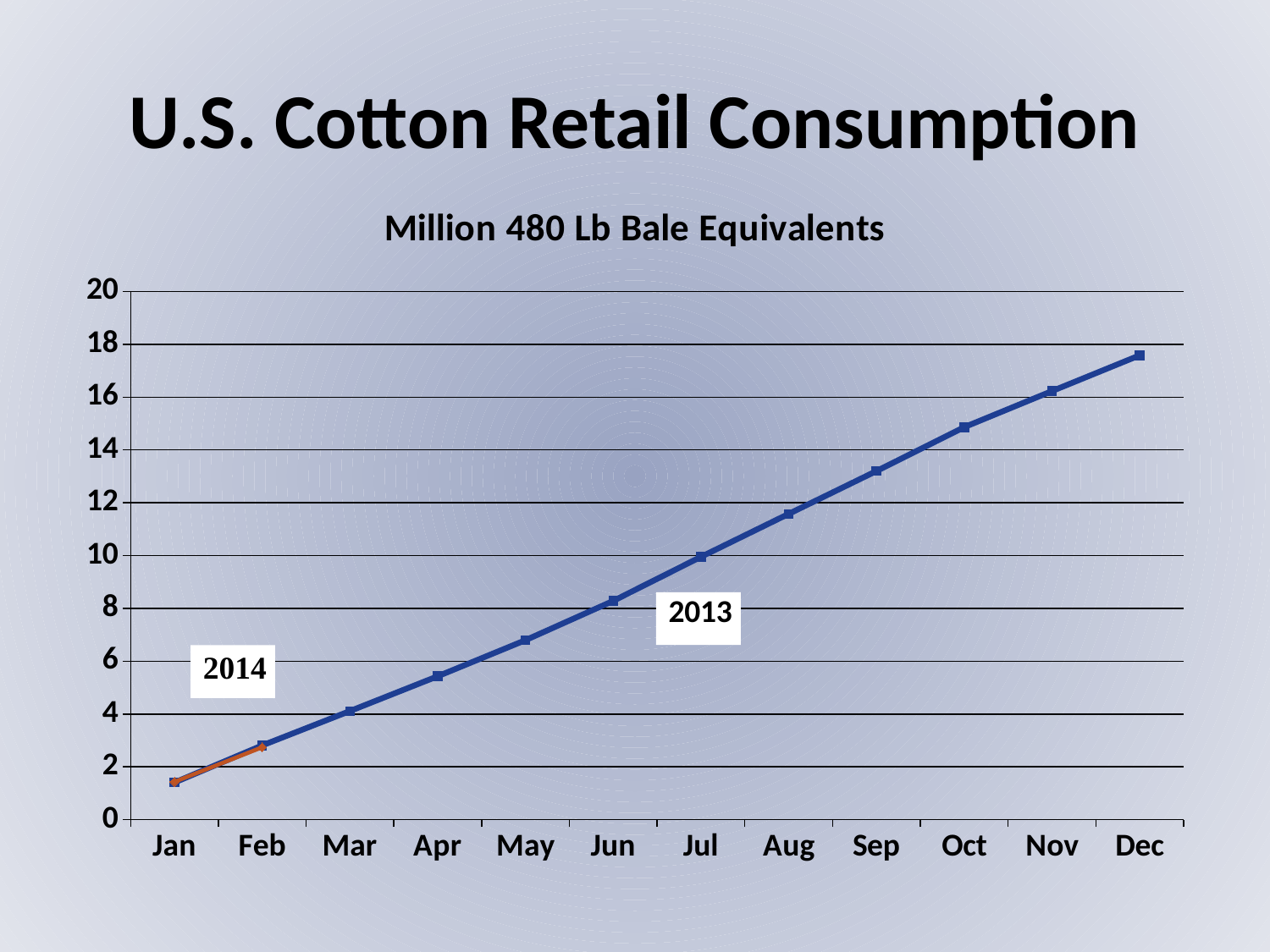
Is the 2013 value for Dec greater or less than 18? less What kind of chart is shown on the slide? line chart How many months are shown along the x axis? 12 In which month is the 2013 value highest? Dec Is the 2013 value for Dec greater or less than 16? greater Which is larger for 2013, the value for Oct or the value for Apr? Oct Do the 2013 values rise or fall from Jan to Dec? rise Is the 2013 value for Sep greater or less than 12? greater In which month is the 2013 value lowest? Jan What unit is given in the chart subtitle? Million 480 Lb Bale Equivalents Which two years are labelled on the chart? 2013 and 2014